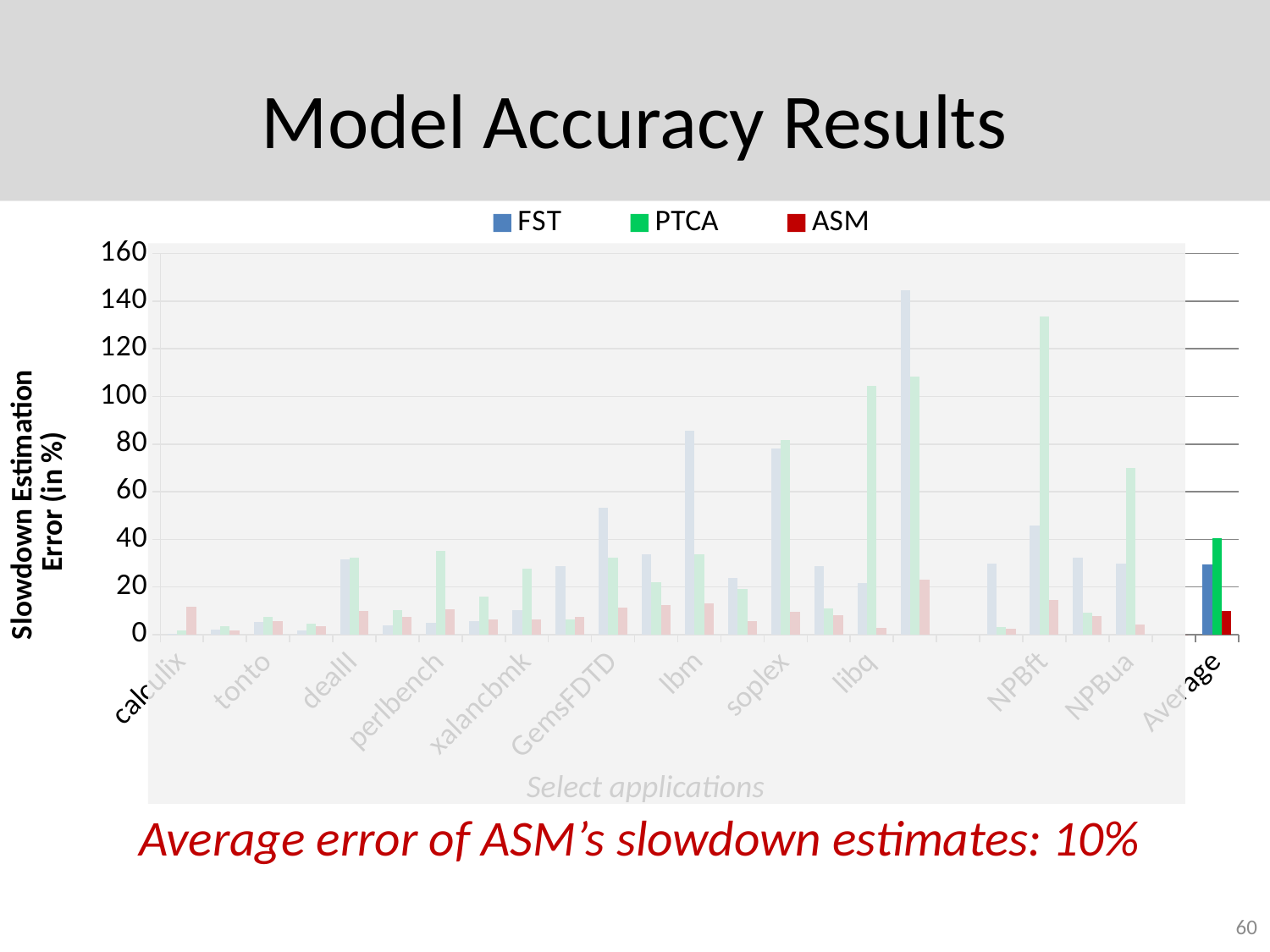
How many series does the legend list? 3 Is the ASM value for Average greater or less than 20? less Is the FST value for Average greater or less than 20? greater For the Average category, which series has the lowest value? ASM Which series are listed in the legend? FST, PTCA, ASM For the Average category, which series has the highest value? PTCA Is the FST value for lbm greater or less than 60? greater What is the average slowdown estimation error of ASM, as stated on the slide? 10% What kind of chart is shown on the slide? bar chart For the Average category, which is larger: the FST value or the ASM value? FST What is the title of the vertical axis? Slowdown Estimation Error (in %)